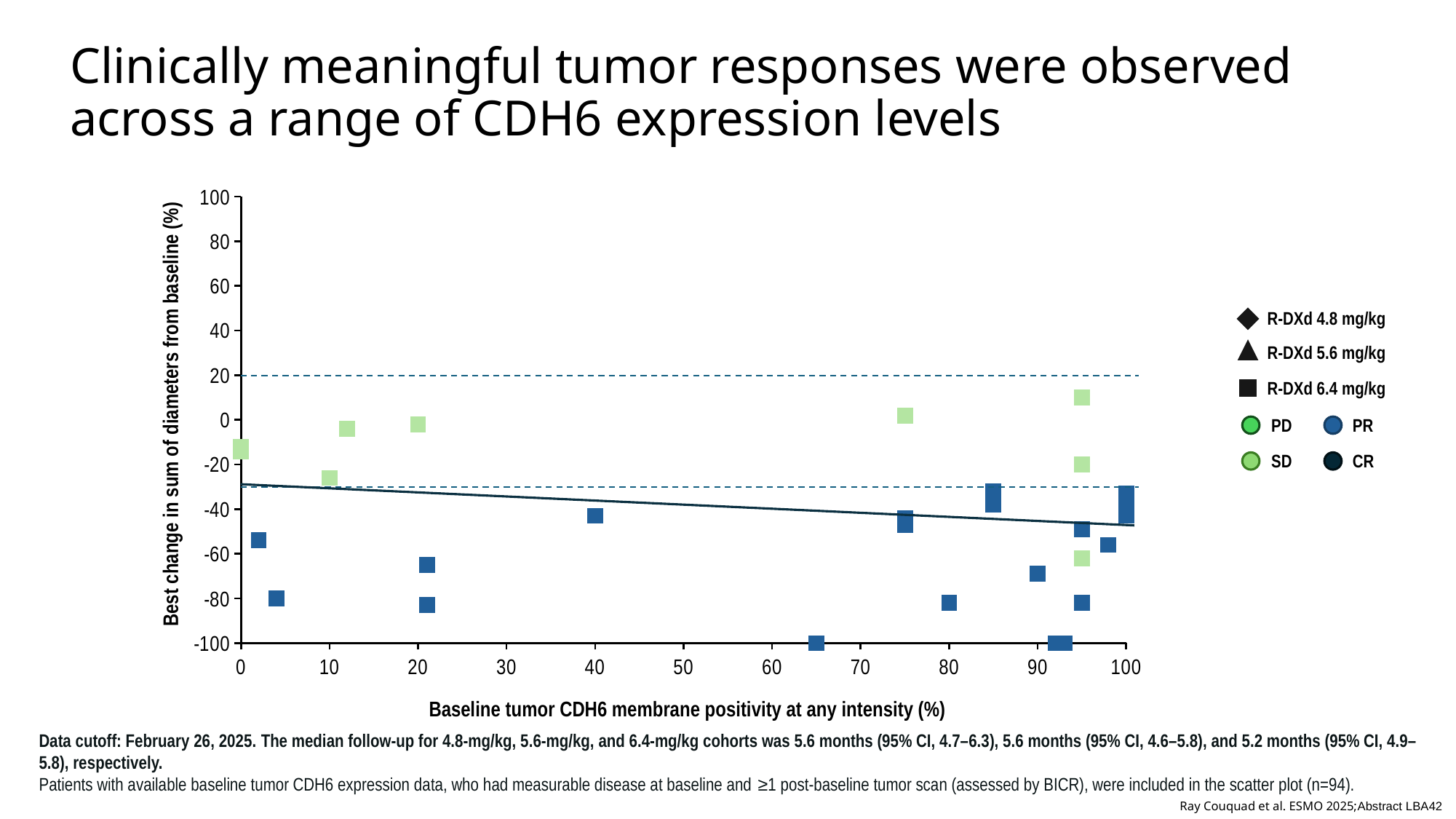
Is the best change from baseline for the highest light green point at about 95% CDH6 positivity greater or less than 0? greater Is the best change from baseline for the point at about 2% CDH6 positivity greater or less than -40? less Is the best change from baseline for the point at about 4% CDH6 positivity greater or less than -60? less What kind of chart is shown on the slide? scatter plot At what y-axis value is the upper dashed horizontal reference line drawn? 20 Does the fitted trend line rise or fall as baseline CDH6 membrane positivity increases? fall How many R-DXd dose levels does the legend list? 3 What is the title of the x axis? Baseline tumor CDH6 membrane positivity at any intensity (%) What is the maximum value shown on the y axis? 100